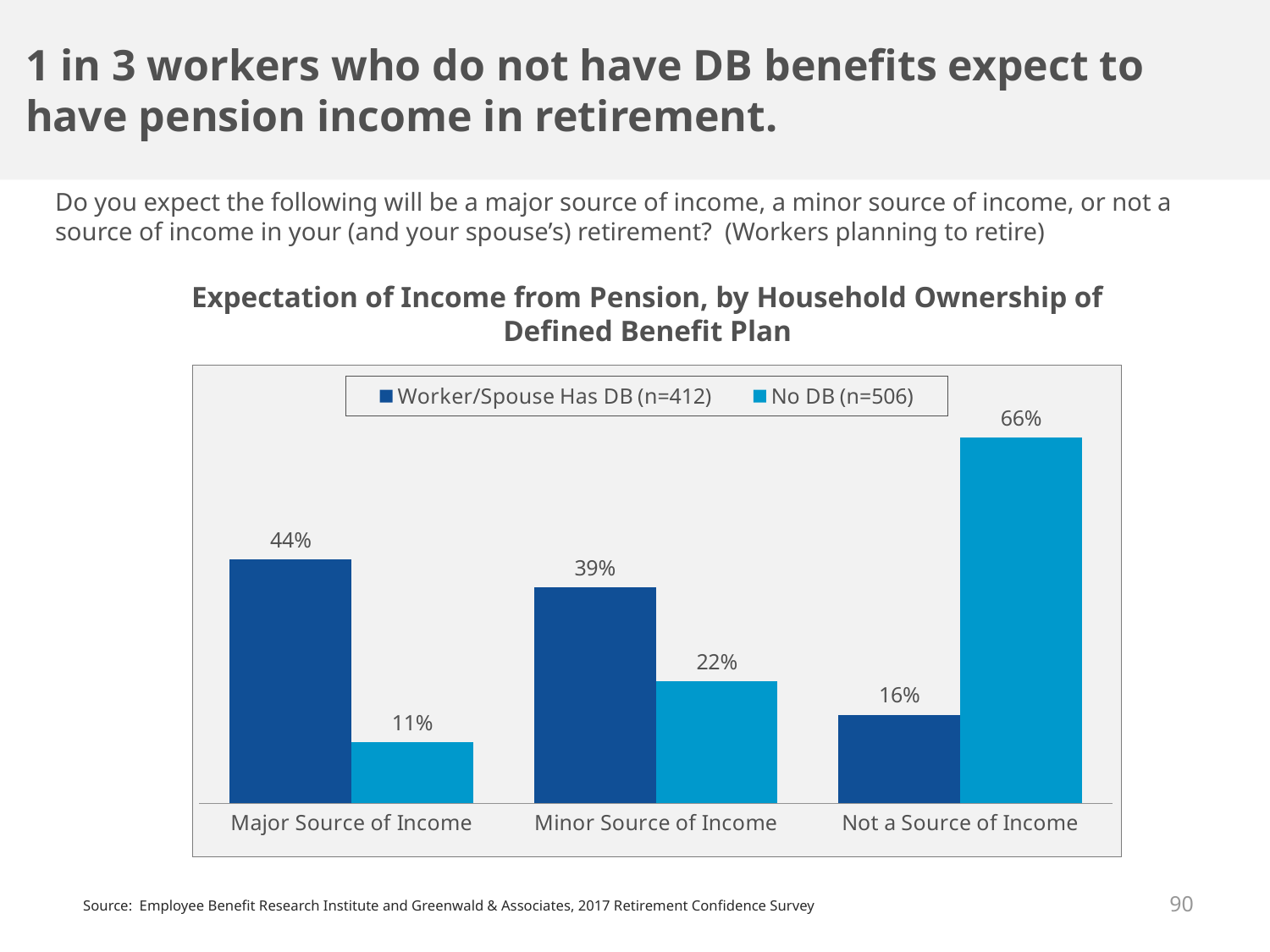
What kind of chart is shown on the slide? Bar chart Which category has the lowest value for the Worker/Spouse Has DB series? Not a Source of Income What percentage of workers whose household has a DB plan expect pension to be a major source of income? 44% What is the value for No DB in the Minor Source of Income category? 22% How many series does the legend list? 2 What is the sample size for the No DB group shown in the legend? n=506 What is the value for Worker/Spouse Has DB in the Not a Source of Income category? 16% What is the difference between the No DB and Worker/Spouse Has DB values for Major Source of Income? 33% What percentage of workers with no DB plan expect pension to be not a source of income? 66% How many categories are shown on the x axis? 3 Which category has the highest value for the No DB series? Not a Source of Income Which is larger in the Minor Source of Income category: Worker/Spouse Has DB or No DB? Worker/Spouse Has DB